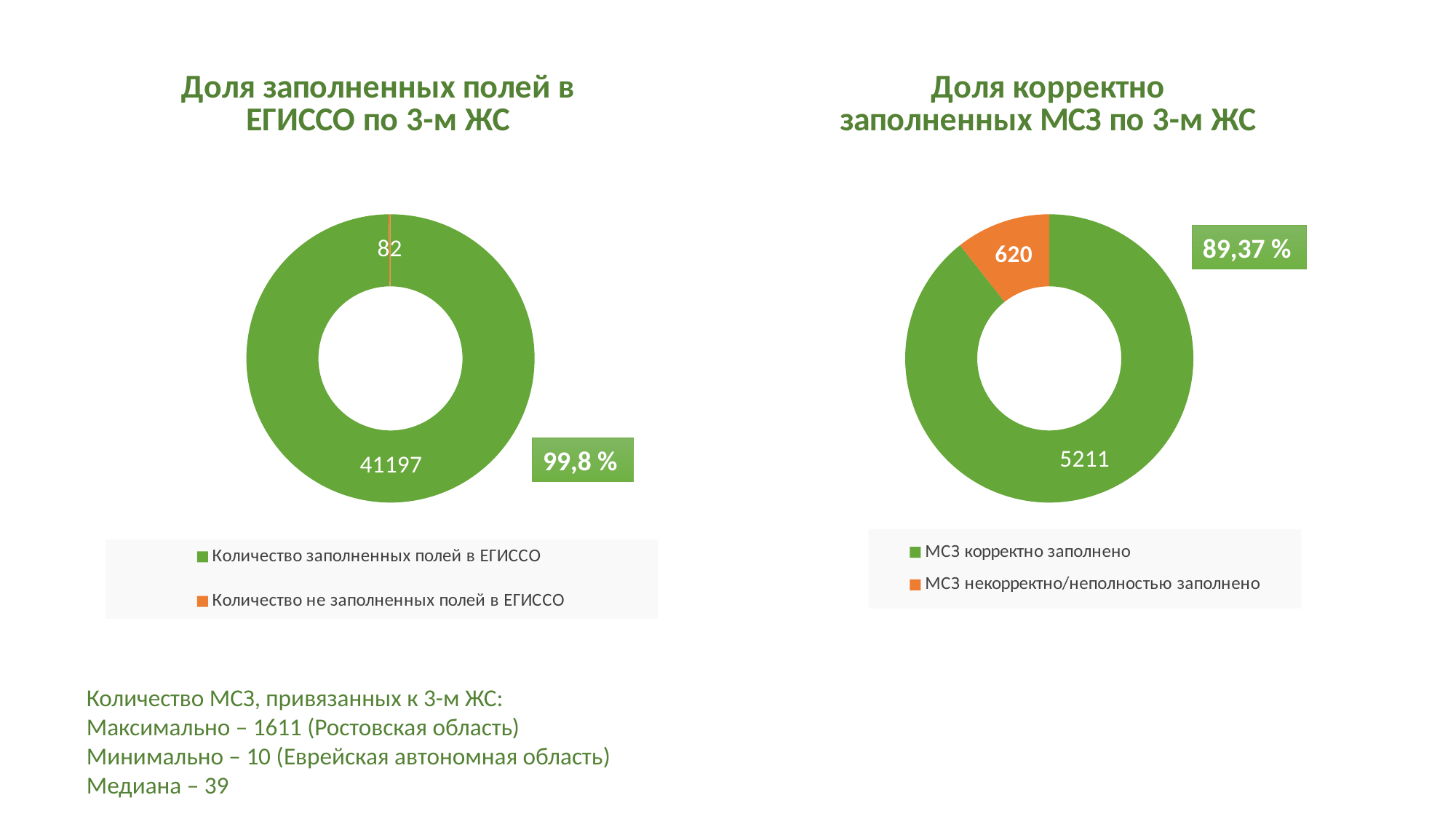
In the left chart 'Доля заполненных полей в ЕГИССО по 3-м ЖС', what is the value for 'Количество заполненных полей в ЕГИССО'? 41197 In the left chart 'Доля заполненных полей в ЕГИССО по 3-м ЖС', what share is shown for the filled fields? 99,8 % How many entries does the legend of the right chart 'Доля корректно заполненных МСЗ по 3-м ЖС' list? 2 In the right chart 'Доля корректно заполненных МСЗ по 3-м ЖС', which category has the largest value? МСЗ корректно заполнено In the left chart 'Доля заполненных полей в ЕГИССО по 3-м ЖС', which category has the smallest value? Количество не заполненных полей в ЕГИССО In the right chart 'Доля корректно заполненных МСЗ по 3-м ЖС', what is the value for 'МСЗ некорректно/неполностью заполнено'? 620 What type of chart is the left chart 'Доля заполненных полей в ЕГИССО по 3-м ЖС'? Doughnut (pie) chart In the left chart 'Доля заполненных полей в ЕГИССО по 3-м ЖС', what is the value for 'Количество не заполненных полей в ЕГИССО'? 82 In the right chart 'Доля корректно заполненных МСЗ по 3-м ЖС', what share is shown for the correctly filled МСЗ? 89,37 % In the right chart 'Доля корректно заполненных МСЗ по 3-м ЖС', what is the difference between the values for 'МСЗ корректно заполнено' and 'МСЗ некорректно/неполностью заполнено'? 4591 In the right chart 'Доля корректно заполненных МСЗ по 3-м ЖС', what is the value for 'МСЗ корректно заполнено'? 5211 In the left chart 'Доля заполненных полей в ЕГИССО по 3-м ЖС', what is the total of the two values shown? 41279